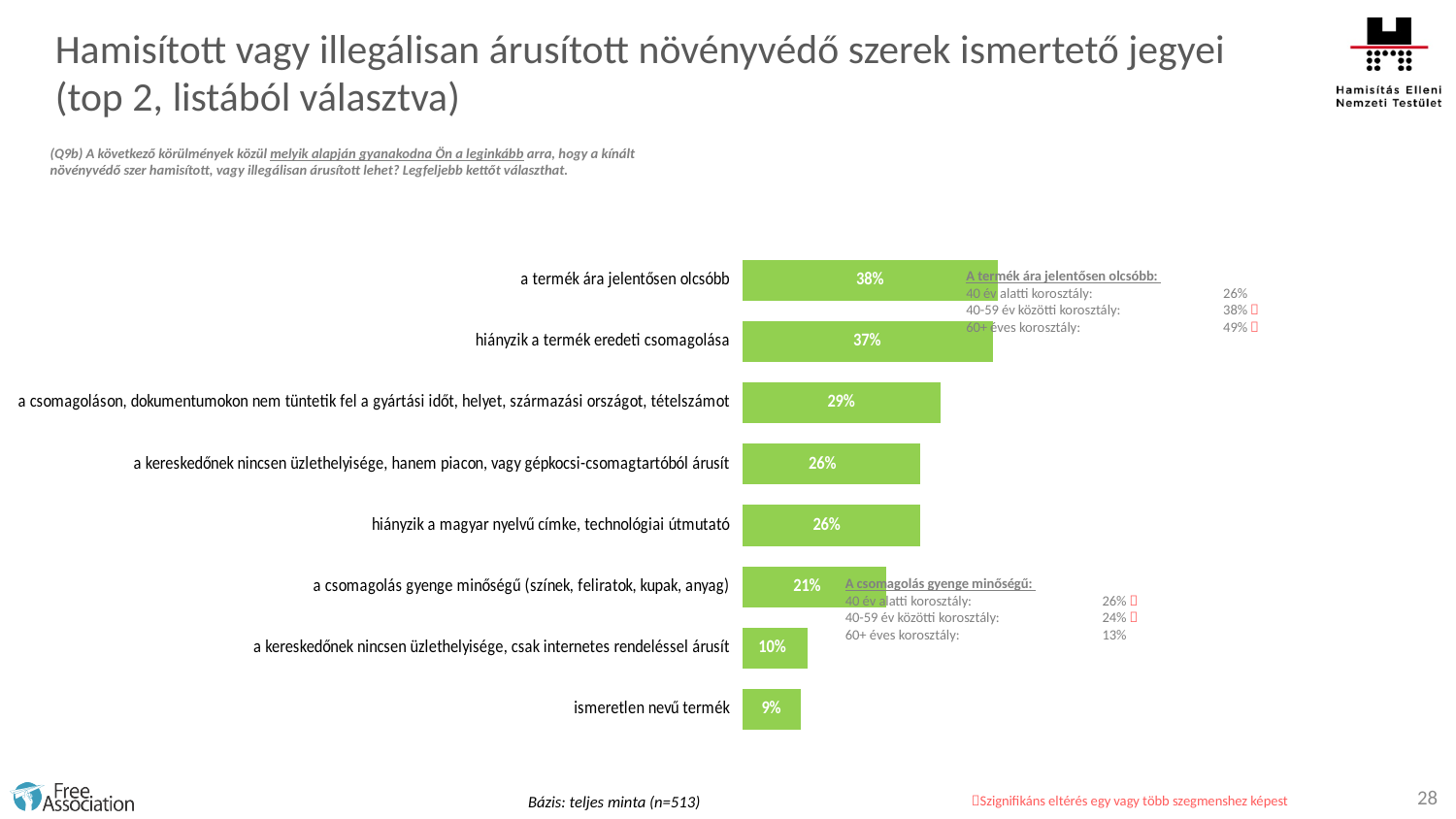
Which is larger: the value for "hiányzik a termék eredeti csomagolása" or for "a csomagoláson, dokumentumokon nem tüntetik fel a gyártási időt, helyet, származási országot, tételszámot"? hiányzik a termék eredeti csomagolása What is the difference between the values for "a termék ára jelentősen olcsóbb" and "ismeretlen nevű termék"? 29 percentage points What is the value for "a csomagolás gyenge minőségű (színek, feliratok, kupak, anyag)"? 21% Which category has the highest value? a termék ára jelentősen olcsóbb Which category has the lowest value? ismeretlen nevű termék Do the values rise or fall going from the top bar to the bottom bar? fall What is the value for "hiányzik a termék eredeti csomagolása"? 37% What is the value for "ismeretlen nevű termék"? 9% How many categories are shown in the chart? 8 What is the value for "a termék ára jelentősen olcsóbb"? 38% According to the annotation for "A termék ára jelentősen olcsóbb", what is the value for the 60+ éves korosztály? 49% What kind of chart is shown on the slide? bar chart